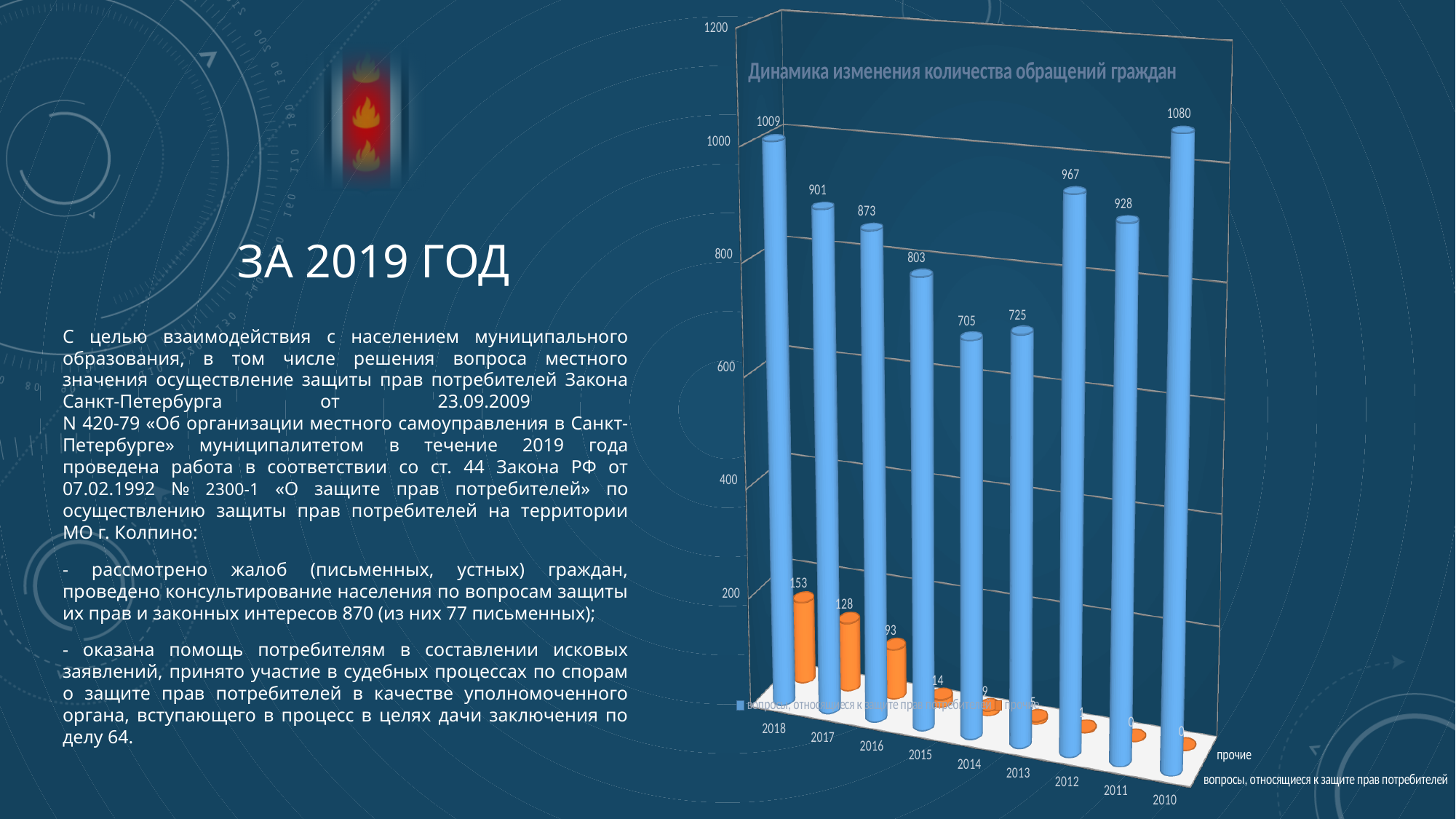
What type of chart is shown on the slide? bar chart What is the difference between the 2010 and 2018 values in the series 'вопросы, относящиеся к защите прав потребителей'? 71 What is the value for 2018 in the series 'вопросы, относящиеся к защите прав потребителей'? 1009 Which is larger in the series 'вопросы, относящиеся к защите прав потребителей': the value for 2012 or the value for 2011? 2012 What is the value for 2018 in the series 'прочие'? 153 What is the title of the chart? Динамика изменения количества обращений граждан How many years are shown on the x axis of the chart? 9 What is the value for 2016 in the series 'прочие'? 93 What is the value for 2015 in the series 'вопросы, относящиеся к защите прав потребителей'? 803 What is the value for 2011 in the series 'прочие'? 0 Which year has the highest value in the series 'вопросы, относящиеся к защите прав потребителей'? 2010 Which year has the lowest value in the series 'вопросы, относящиеся к защите прав потребителей'? 2014